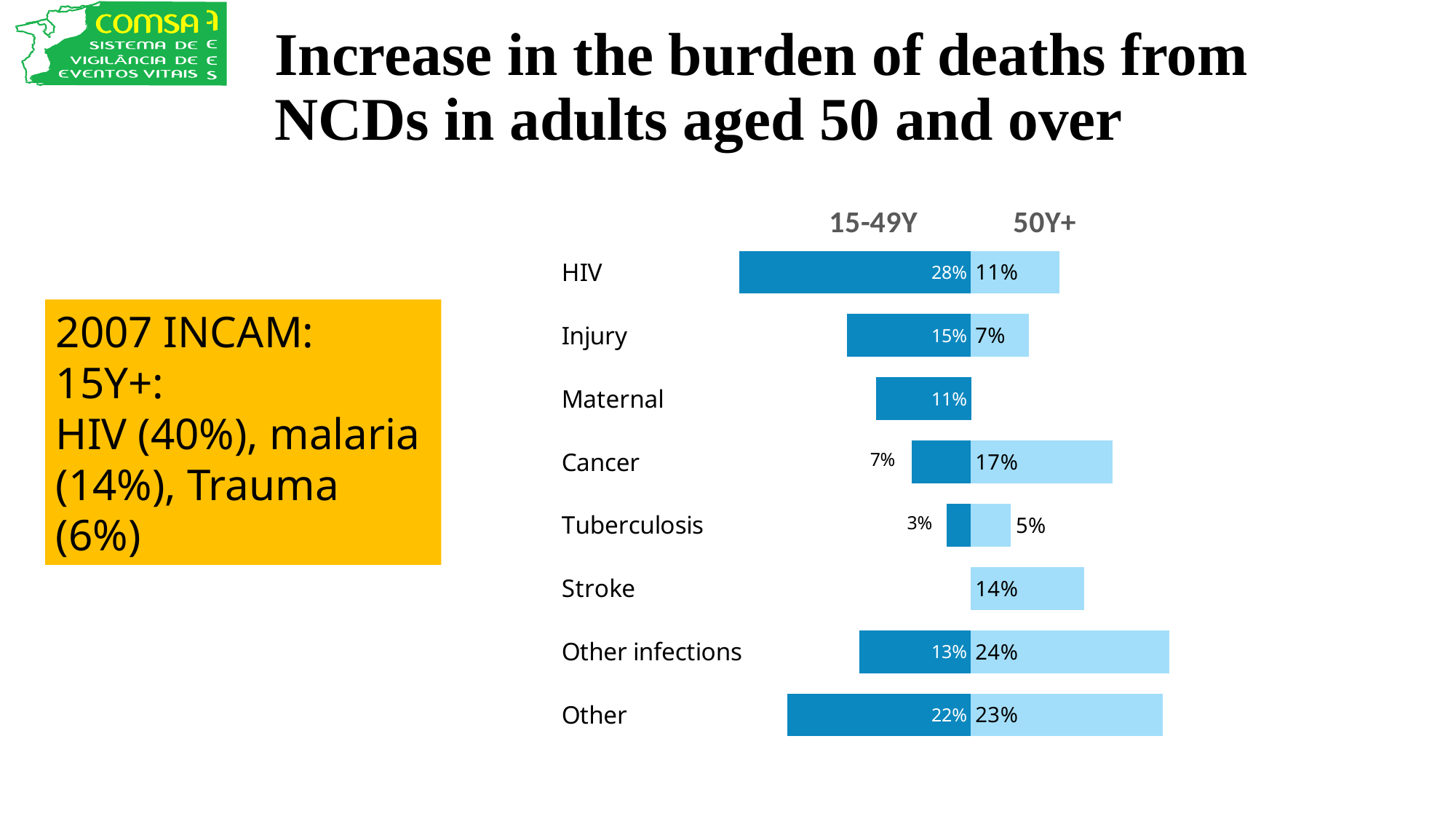
Which category has the highest value in the 50Y+ series? Other infections What is the value for Cancer in the 50Y+ series? 17% How many series does the chart show? 2 What kind of chart is shown on the slide? Bar chart What is the value for Stroke in the 50Y+ series? 14% What is the value for Maternal in the 15-49Y series? 11% How many categories are shown in the chart? 8 Which is larger for Cancer: the 15-49Y value or the 50Y+ value? 50Y+ What is the value for HIV in the 15-49Y series? 28% What is the difference between the 15-49Y and 50Y+ values for HIV? 17% Which category has the highest value in the 15-49Y series? HIV